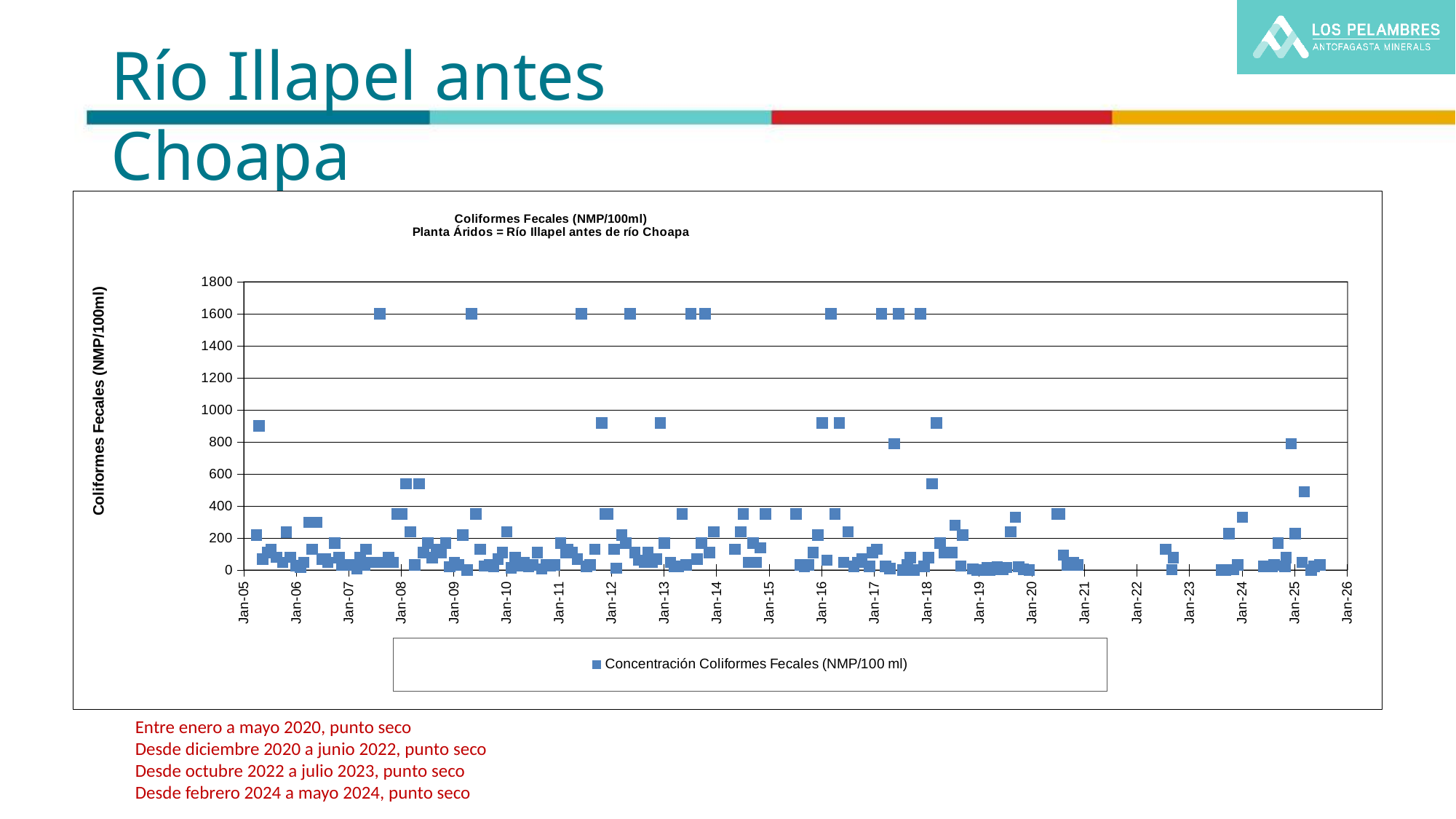
What is the highest value reached by any plotted point? 1600 Is the highest point plotted near Jan-25 greater or less than 1000? less How many series does the legend list? 1 Are any plotted points above 1600? No What is the highest value shown on the vertical axis? 1800 What kind of chart is shown on the slide? scatter chart What is the label of the vertical axis? Coliformes Fecales (NMP/100ml) What is the last date label shown on the horizontal axis? Jan-26 What is the legend entry for the plotted series? Concentración Coliformes Fecales (NMP/100 ml)